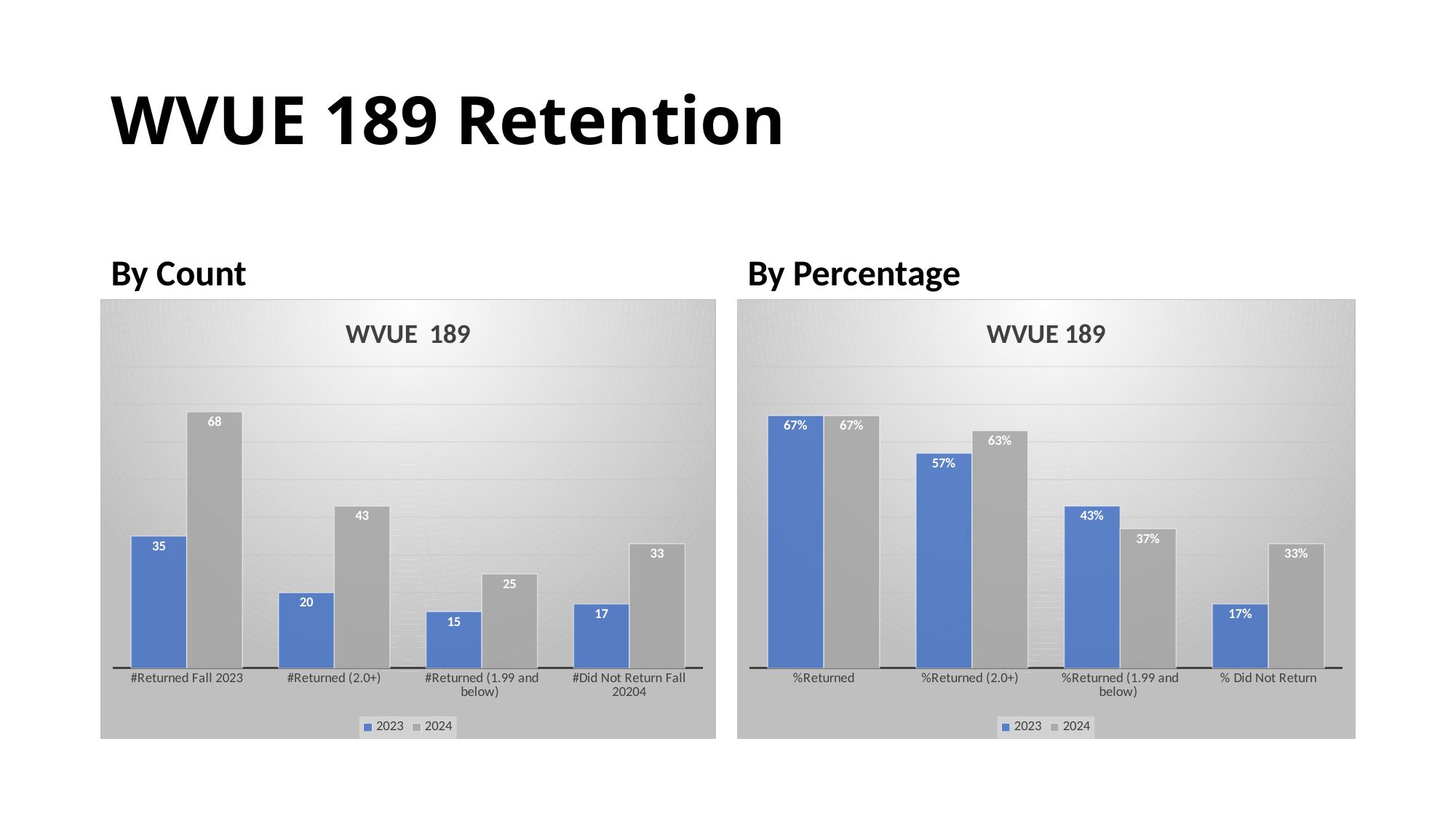
In the By Percentage chart, which is larger for %Returned (1.99 and below), the 2023 value or the 2024 value? 2023 In the By Count chart, which category has the lowest 2023 value? #Returned (1.99 and below) In the By Percentage chart, what is the 2023 value for % Did Not Return? 17% In the By Count chart, which category has the highest 2024 value? #Returned Fall 2023 In the By Count chart, what is the 2024 value for #Returned Fall 2023? 68 In the By Count chart, what is the difference between the 2024 and 2023 values for #Returned (2.0+)? 23 What type of chart is the By Count chart? Bar chart In the By Count chart, what is the 2023 value for #Returned (1.99 and below)? 15 In the By Count chart, how many categories are shown on the x axis? 4 How many series does the legend of the By Percentage chart list? 2 In the By Percentage chart, what is the 2024 value for %Returned (2.0+)? 63% In the By Percentage chart, what is the difference between the 2024 and 2023 values for % Did Not Return? 16%